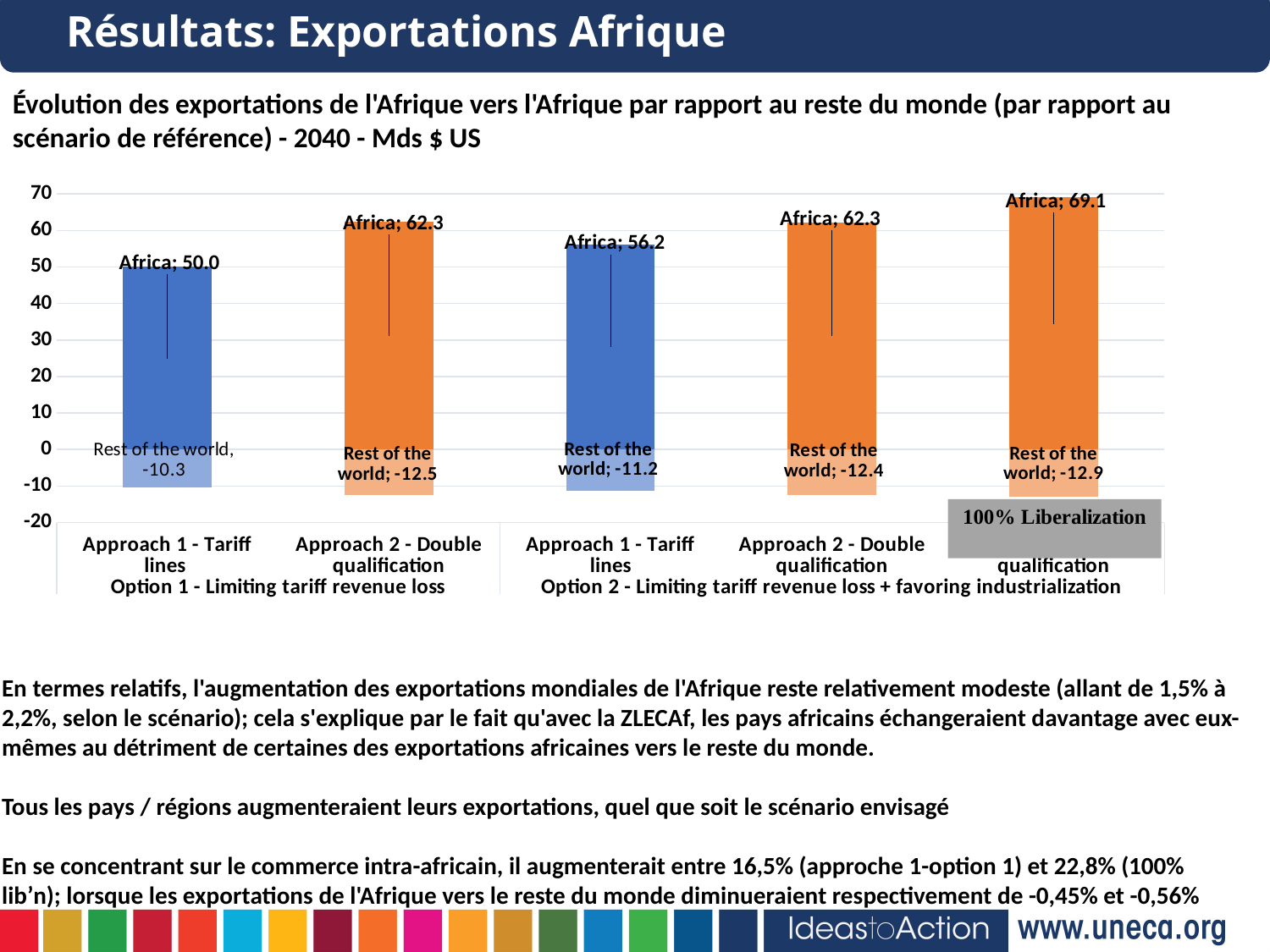
Which scenario has the highest Africa value? 100% Liberalization What kind of chart is shown on the slide? Bar chart What is the Africa value for the 100% Liberalization scenario? 69.1 What is the Rest of the world value for Approach 2 - Double qualification under Option 2? -12.4 What is the Rest of the world value for Approach 2 - Double qualification under Option 1? -12.5 What is the difference between the Africa value for 100% Liberalization and the Africa value for Approach 1 - Tariff lines under Option 1? 19.1 What is the Rest of the world value for Approach 1 - Tariff lines under Option 2? -11.2 What is the Africa value for Approach 2 - Double qualification under Option 1? 62.3 Which is larger: the Africa value for Approach 1 - Tariff lines under Option 2 or the Africa value for Approach 2 - Double qualification under Option 2? Approach 2 - Double qualification under Option 2 Which scenario has the lowest Africa value? Approach 1 - Tariff lines (Option 1 - Limiting tariff revenue loss) How many scenarios (bars) are shown on the x axis? 5 What is the Africa value for Approach 1 - Tariff lines under Option 1 - Limiting tariff revenue loss? 50.0